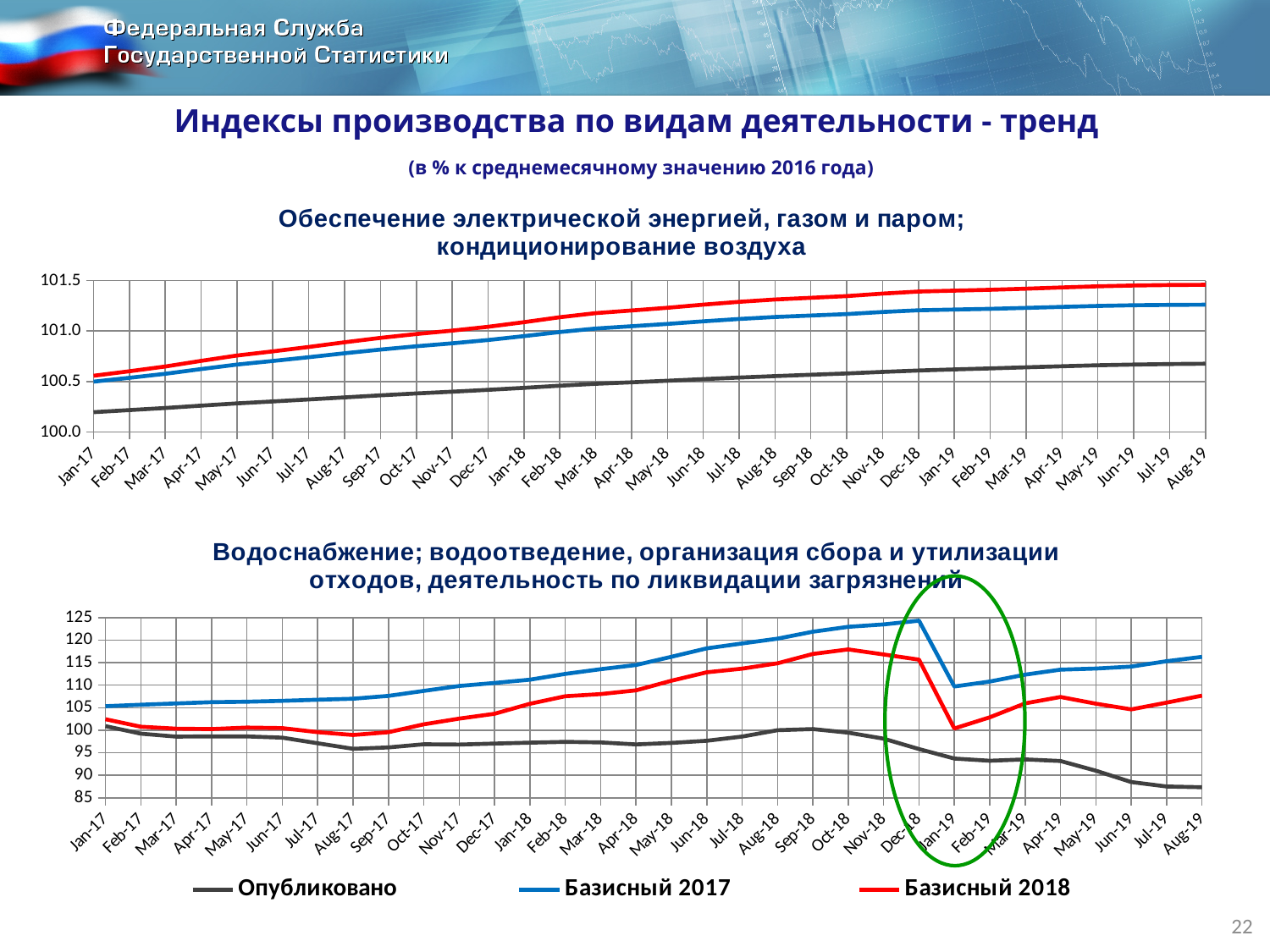
In the bottom chart (Водоснабжение; водоотведение...), is the value for Базисный 2017 at Dec-18 greater or less than 120? greater What kind of chart is the top chart titled "Обеспечение электрической энергией, газом и паром; кондиционирование воздуха"? Line chart In the top chart (Обеспечение электрической энергией...), is the value for Базисный 2018 at Aug-19 greater or less than 101.0? greater In the top chart (Обеспечение электрической энергией...), do the values of the Базисный 2018 series rise or fall from Jan-17 to Aug-19? Rise What colour is the line for the Базисный 2018 series in the legend? Red In the top chart (Обеспечение электрической энергией...), which series is higher at Aug-19: Базисный 2017 or Опубликовано? Базисный 2017 In the top chart (Обеспечение электрической энергией...), is the value for Опубликовано at Jan-17 greater or less than 100.5? less In the bottom chart (Водоснабжение; водоотведение...), how many months are shown on the x axis from Jan-17 to Aug-19? 32 In the bottom chart (Водоснабжение; водоотведение...), in which month does the Базисный 2017 series reach its highest value? Dec-18 In the bottom chart (Водоснабжение; водоотведение...), which series has the lowest value at Aug-19? Опубликовано How many series does the legend at the bottom of the slide list? 3